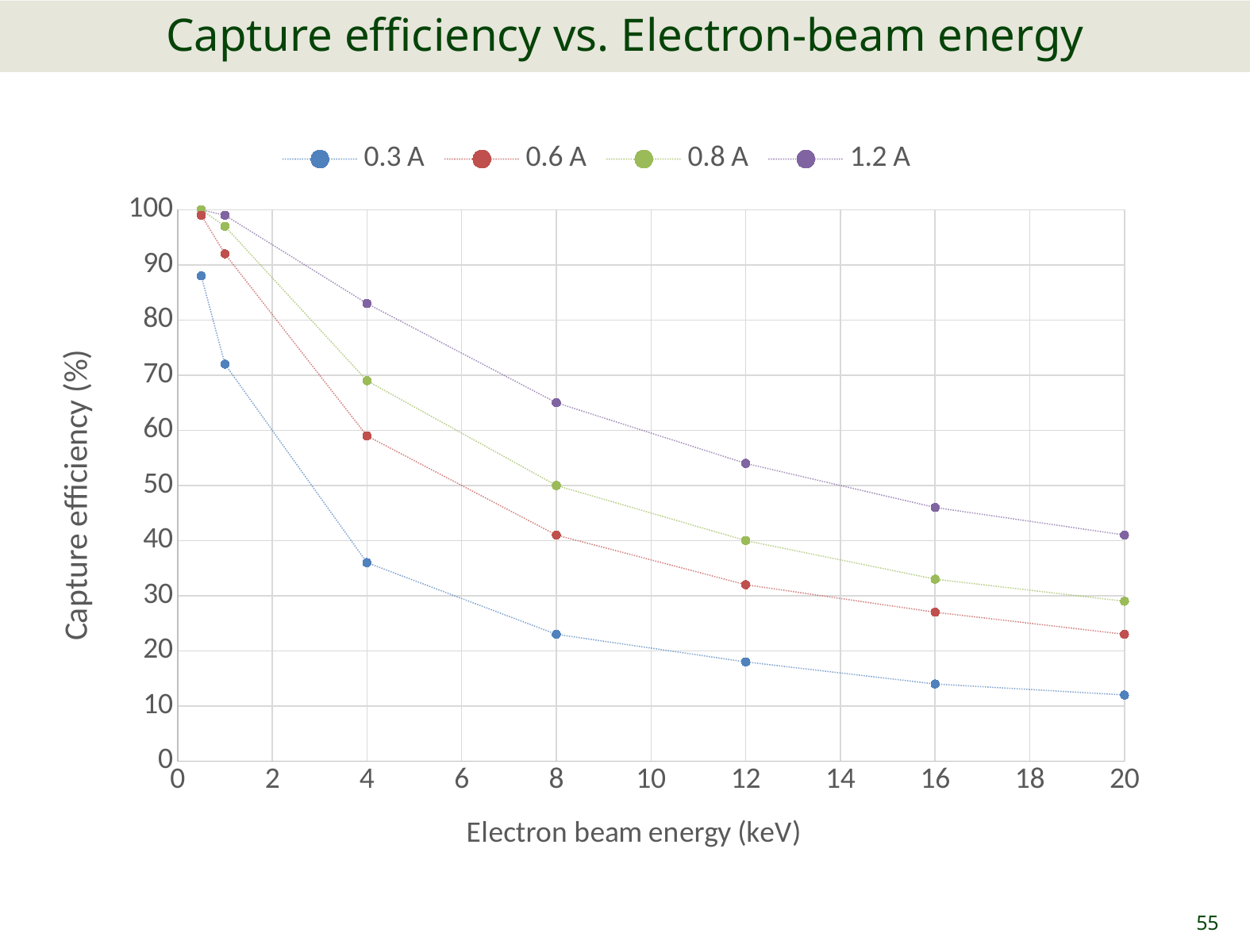
At 12 keV, which series has the larger capture efficiency, 0.6 A or 0.8 A? 0.8 A How many series does the legend list? 4 Which series has the lowest capture efficiency at 8 keV? 0.3 A What is the title of the chart? Capture efficiency vs. Electron-beam energy What kind of chart is shown on the slide? line chart Is the capture efficiency for the 1.2 A series at 4 keV greater or less than 80? greater Is the capture efficiency for the 1.2 A series at 16 keV greater or less than 40? greater Does capture efficiency rise or fall as electron beam energy increases for the 0.6 A series? fall Which series has the highest capture efficiency at 20 keV? 1.2 A What is the label of the x axis? Electron beam energy (keV) Is the capture efficiency for the 0.6 A series at 20 keV greater or less than 30? less